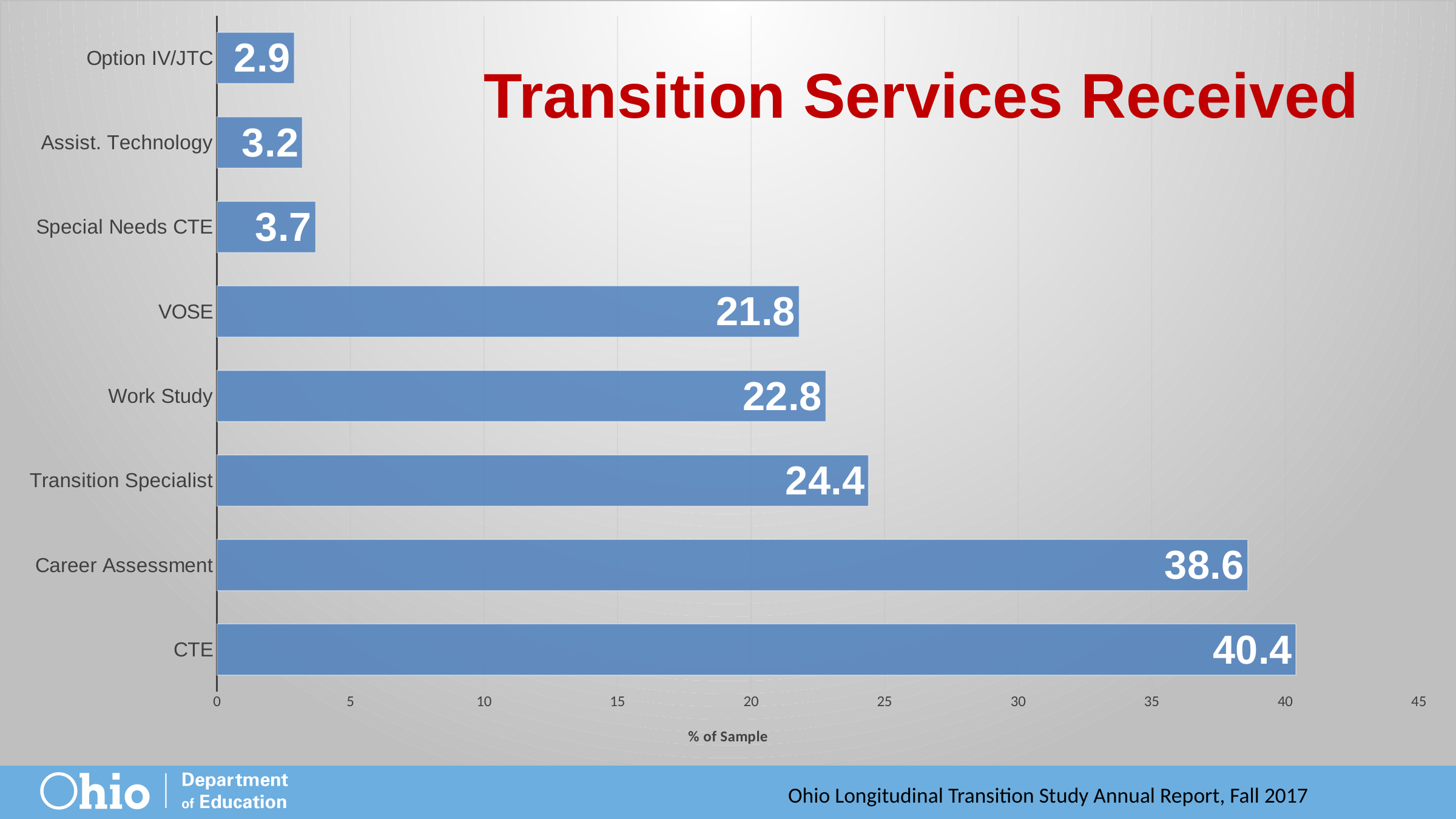
Which is larger, the value for Special Needs CTE or the value for Assist. Technology? Special Needs CTE What kind of chart is shown on the slide? bar chart Is the value for Career Assessment greater or less than 35? greater Which category has the lowest value? Option IV/JTC How many categories are shown in the chart? 8 What is the value for Option IV/JTC? 2.9 What is the title of the chart? Transition Services Received What is the value for CTE? 40.4 What is the difference between the values for CTE and Career Assessment? 1.8 Which category has the highest value? CTE What is the value for Work Study? 22.8 What is the difference between the values for Transition Specialist and VOSE? 2.6